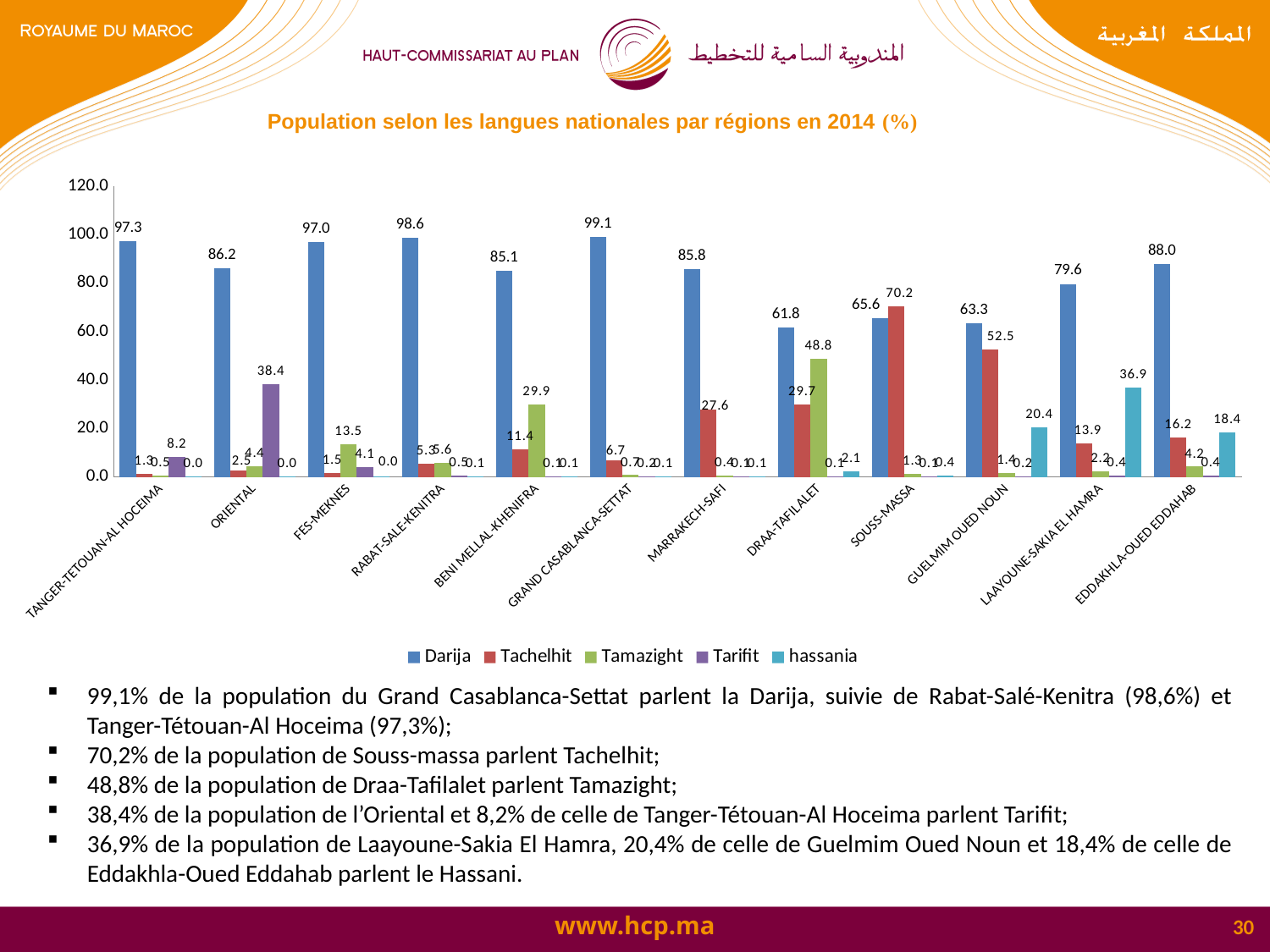
Which is larger for Souss-Massa: the Darija value or the Tachelhit value? Tachelhit What type of chart is shown on the slide? bar chart What is the Darija value for Grand Casablanca-Settat? 99.1 What is the Tachelhit value for Souss-Massa? 70.2 How many series does the legend list? 5 How many regions are shown on the x axis? 12 What is the hassania value for Laayoune-Sakia El Hamra? 36.9 Which region has the lowest Darija value? Draa-Tafilalet What is the Tarifit value for Oriental? 38.4 Which region has the highest Darija value? Grand Casablanca-Settat What is the Tamazight value for Draa-Tafilalet? 48.8 What is the difference between the Darija values for Rabat-Sale-Kenitra and Tanger-Tetouan-Al Hoceima? 1.3